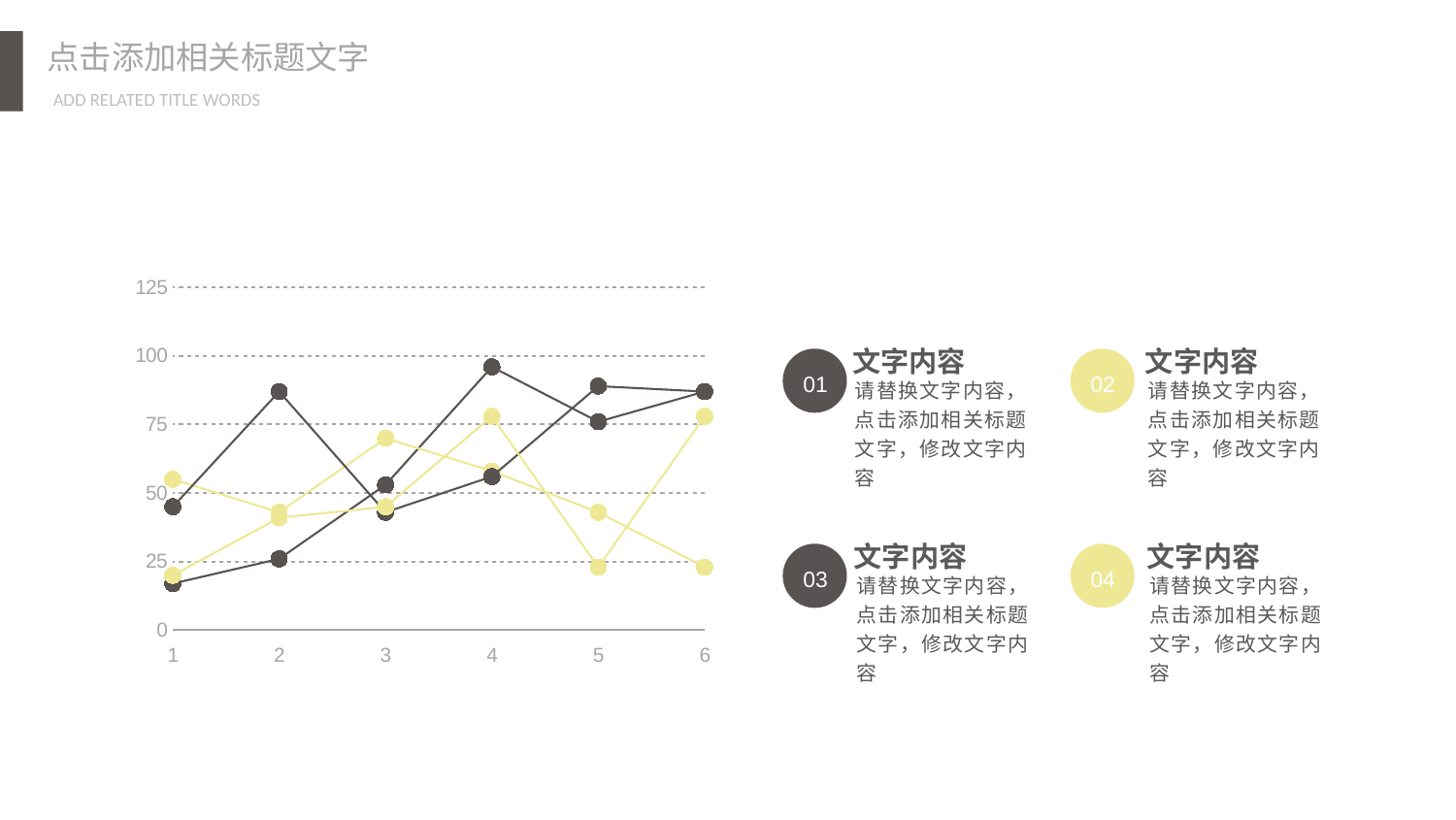
Is the highest point plotted on the chart greater or less than 100? less How many points are labelled along the x axis of the chart? 6 What kind of chart is shown on the slide? line chart Is the highest point plotted on the chart greater or less than 75? greater At which x-axis point does the highest value on the chart occur? 4 What is the highest value shown on the y axis of the chart? 125 How many lines are plotted on the chart? 4 Is the lowest point plotted on the chart greater or less than 25? less What is the lowest value shown on the y axis of the chart? 0 What two colours are used for the lines on the chart? dark grey and yellow